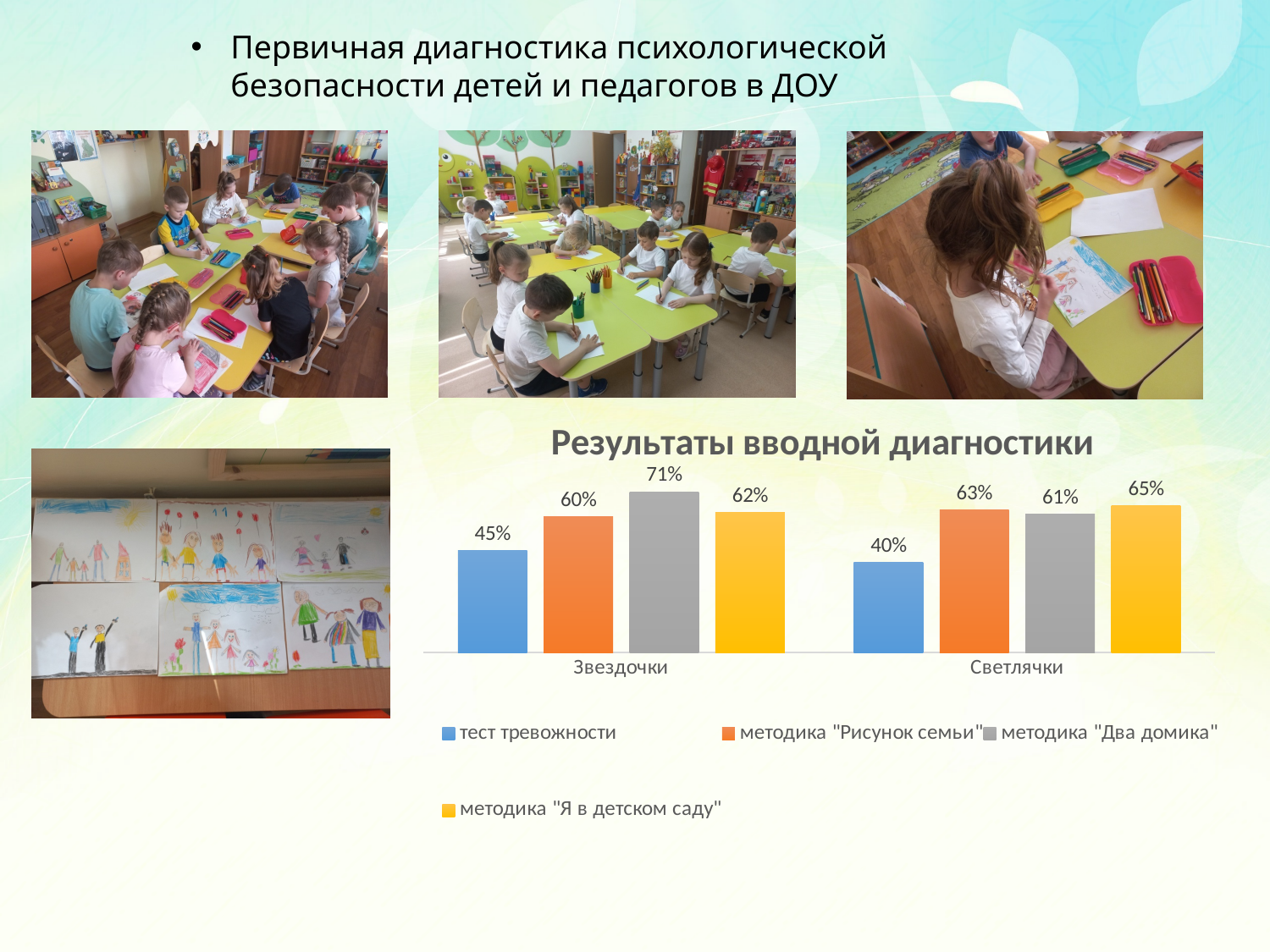
What is the value for методика "Два домика" in the Светлячки group? 61% What is the title of the chart? Результаты вводной диагностики Which series has the lowest value in the Светлячки group? тест тревожности What kind of chart is shown on the slide? bar chart What is the value for тест тревожности in the Звездочки group? 45% Which group has the larger value for методика "Рисунок семьи", Звездочки or Светлячки? Светлячки How many groups (categories) are shown on the x axis? 2 What is the difference between the тест тревожности values for Звездочки and Светлячки? 5% How many series does the legend list? 4 What colour are the bars for методика "Два домика"? grey Which series has the highest value in the Звездочки group? методика "Два домика" What is the value for методика "Я в детском саду" in the Звездочки group? 62%